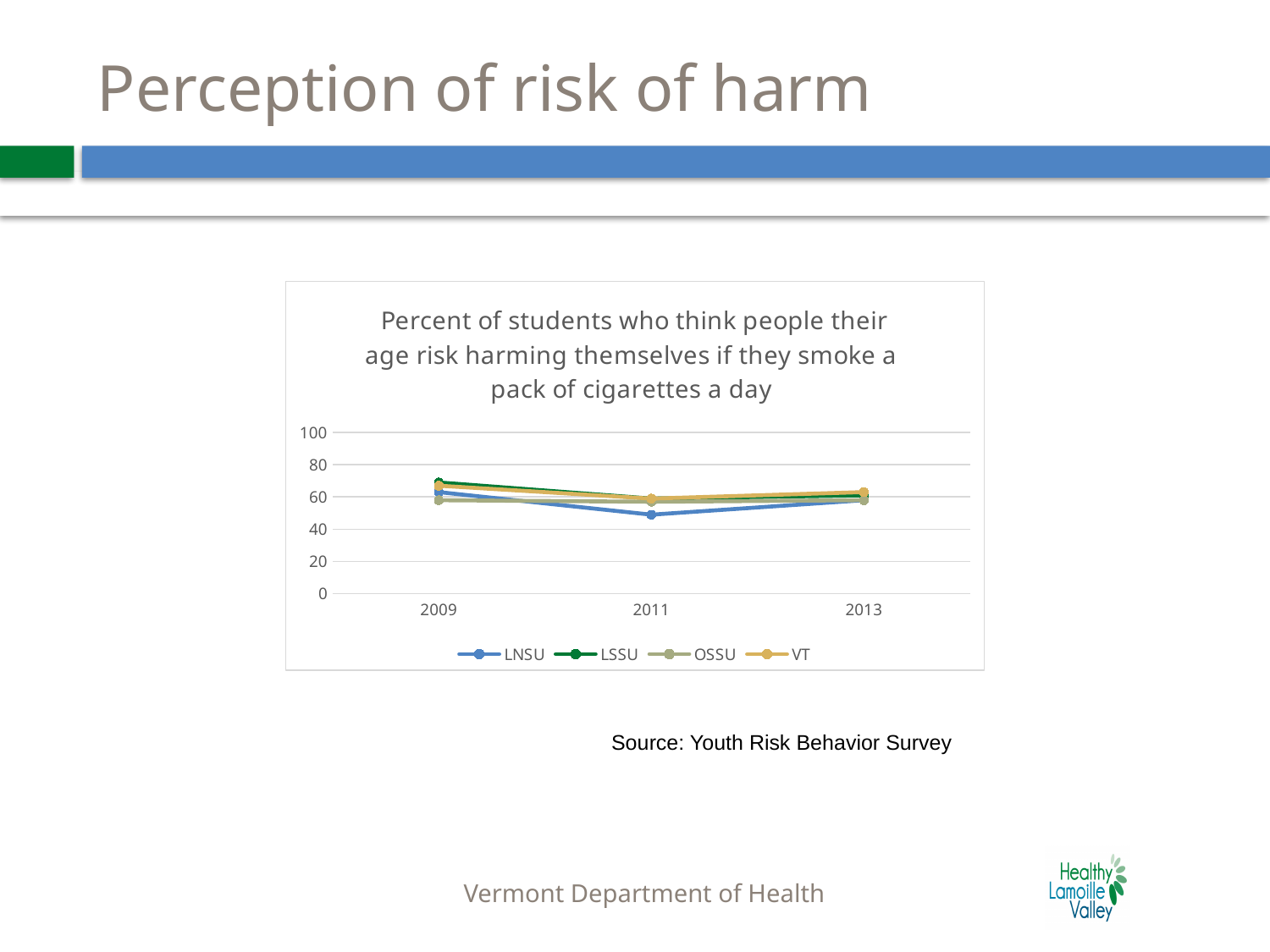
Is the value for LNSU in 2011 greater or less than 60? less Does the LNSU line rise or fall from 2009 to 2011? fall Is the value for LSSU in 2009 greater or less than 60? greater What is the title of the chart? Percent of students who think people their age risk harming themselves if they smoke a pack of cigarettes a day Which is larger in 2011, the value for LNSU or the value for LSSU? LSSU Which series has the lowest value in 2011? LNSU What kind of chart is shown on the slide? line chart How many series does the legend list? 4 In which year is the LNSU value lowest? 2011 Which series is shown in the legend immediately after LSSU? OSSU How many years are shown on the x axis? 3 Is the value for LNSU in 2011 greater or less than 40? greater